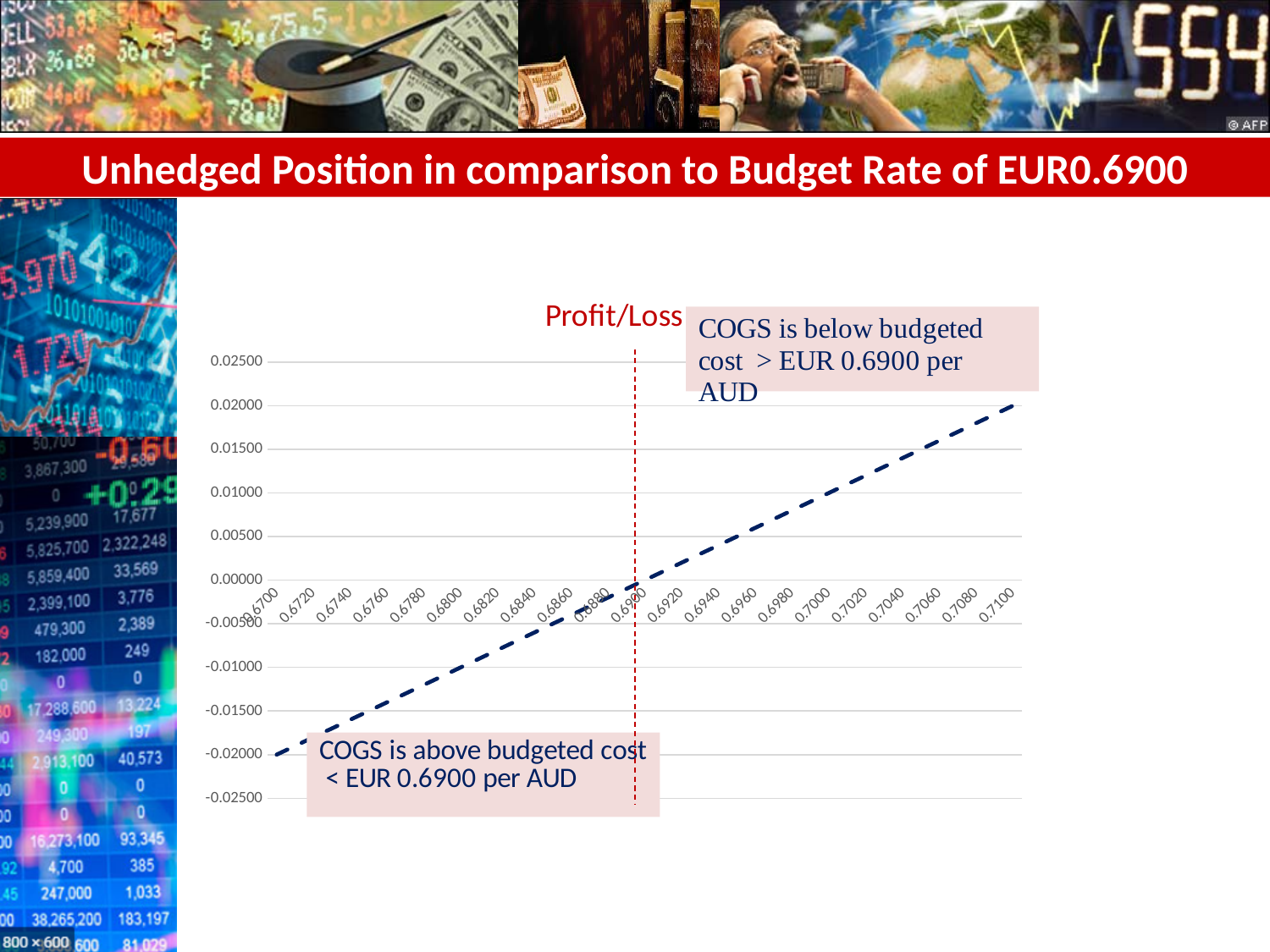
How many exchange rate tick labels are shown along the x axis? 21 What is the Profit/Loss value at an exchange rate of 0.6700? -0.02000 Do the Profit/Loss values rise or fall as the exchange rate increases along the x axis? rise What is the Profit/Loss value at an exchange rate of 0.7100? 0.02000 What kind of chart is shown on the slide? line chart At which exchange rate on the x axis is the Profit/Loss highest? 0.7100 What is the Profit/Loss value at an exchange rate of 0.6900? 0.00000 At which exchange rate on the x axis is the Profit/Loss lowest? 0.6700 Is the Profit/Loss value at 0.6760 greater or less than -0.01000? less Which has the larger Profit/Loss value, an exchange rate of 0.6800 or 0.7000? 0.7000 What is the title of the chart? Profit/Loss